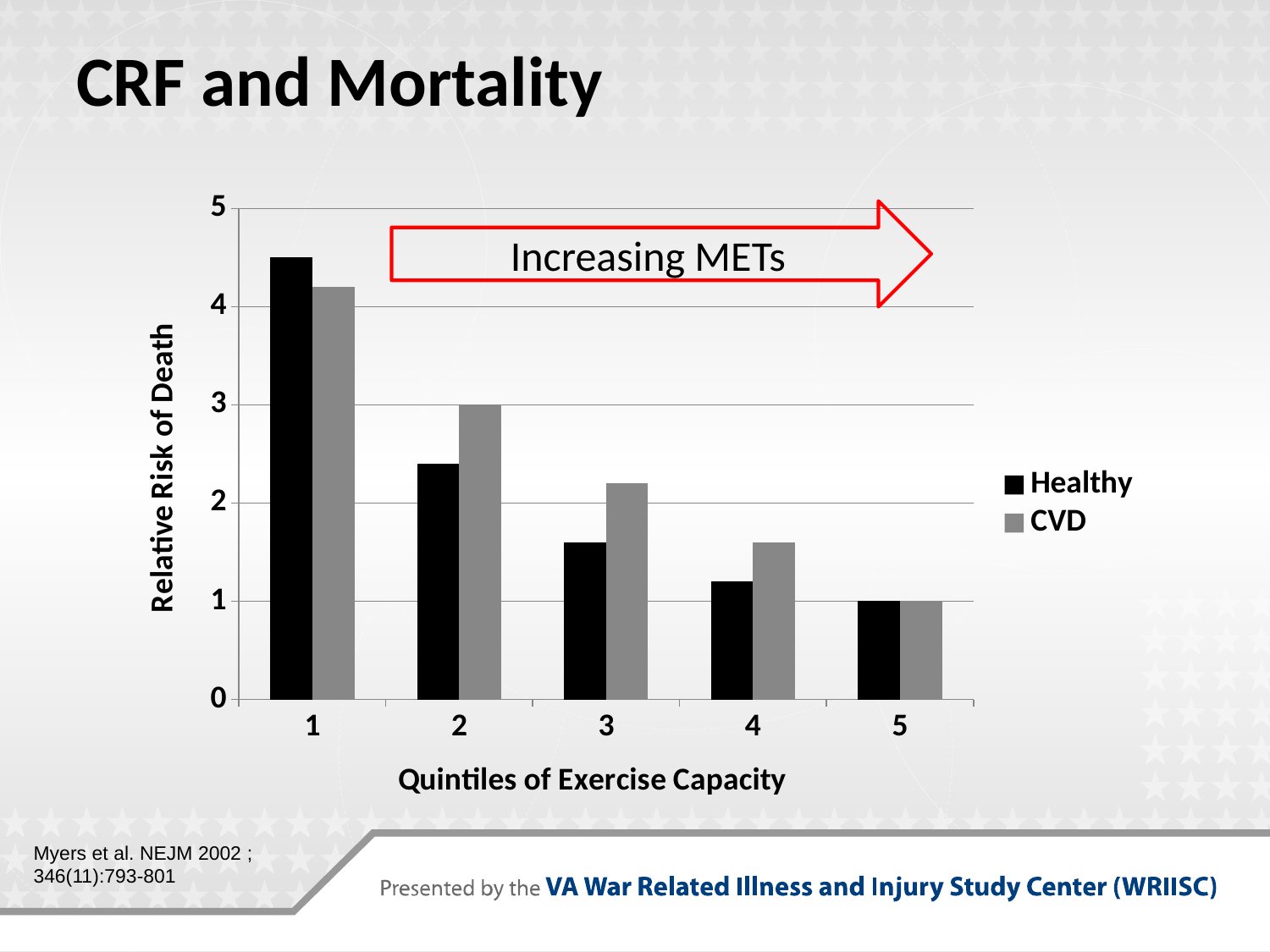
What is the relative risk of death for the Healthy group in quintile 5? 1 Which quintile has the lowest relative risk of death for the CVD group? 5 Is the value for the Healthy group in quintile 3 greater or less than 2? less What type of chart is shown on the slide? bar chart Is the value for the Healthy group in quintile 1 greater or less than 4? greater In quintile 2, which group has the larger relative risk of death, Healthy or CVD? CVD Which quintile has the highest relative risk of death for the Healthy group? 1 How many series does the legend list? 2 Do the relative risk values rise or fall as the quintile of exercise capacity increases? fall Is the value for the CVD group in quintile 3 greater or less than 2? greater What is the relative risk of death for the CVD group in quintile 2? 3 How many quintile categories are shown on the x axis? 5